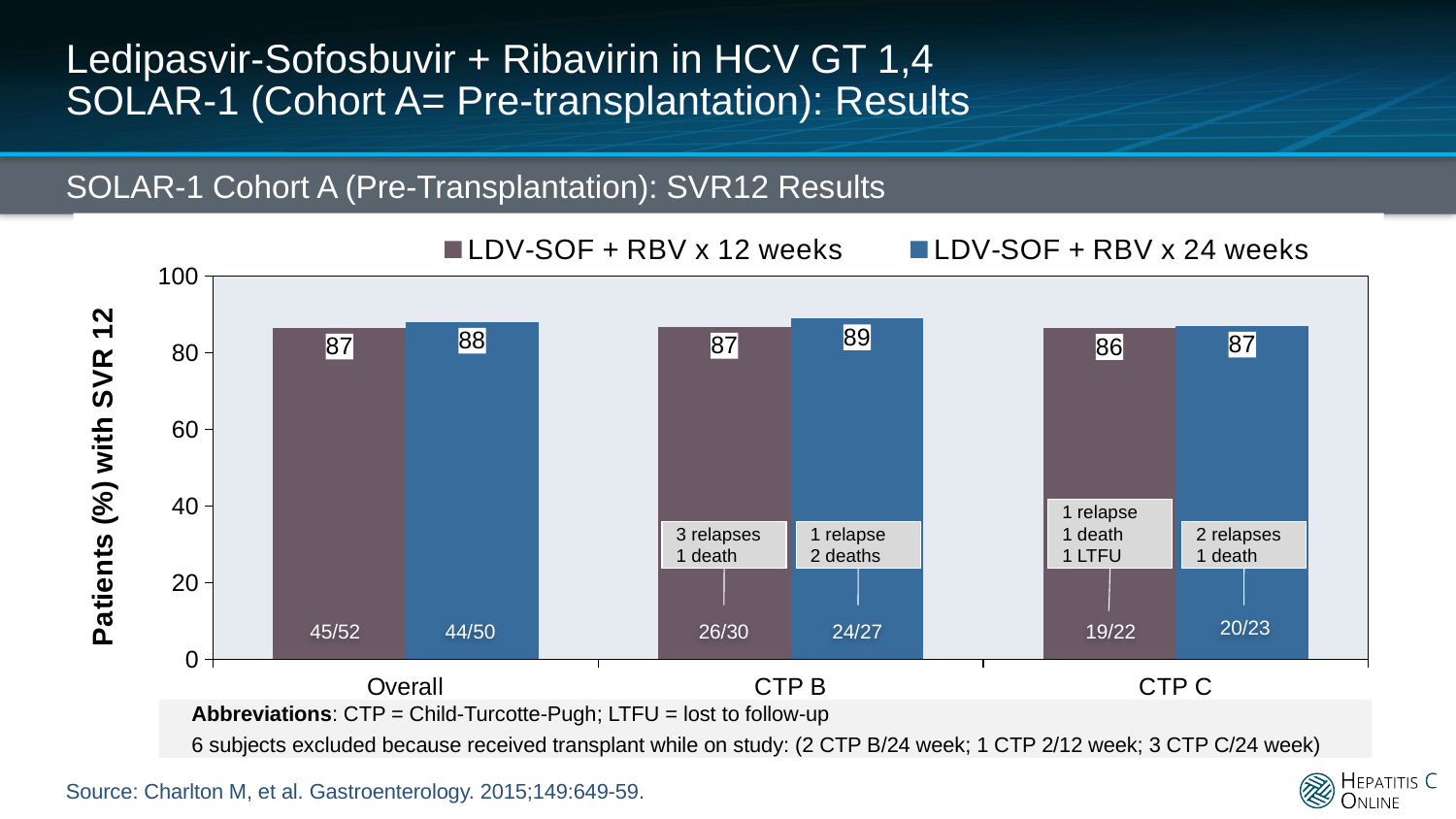
How many categories are shown on the x axis? 3 What fraction of patients achieved SVR12 in the LDV-SOF + RBV x 24 weeks group in the CTP C category? 20/23 How many series does the legend list? 2 What is the SVR12 rate for the LDV-SOF + RBV x 12 weeks group in the Overall category? 87 Which category has the highest SVR12 rate for the LDV-SOF + RBV x 24 weeks group? CTP B In the CTP C category, which group has the higher SVR12 rate, 12 weeks or 24 weeks? LDV-SOF + RBV x 24 weeks What kind of chart is shown on the slide? Bar chart What is the SVR12 rate for the LDV-SOF + RBV x 24 weeks group in the CTP B category? 89 What is the difference between the 24-week and 12-week SVR12 rates in the CTP B category? 2 Which category has the lowest SVR12 rate for the LDV-SOF + RBV x 12 weeks group? CTP C What is the SVR12 rate for the LDV-SOF + RBV x 12 weeks group in the CTP C category? 86 What is the label of the y axis? Patients (%) with SVR 12